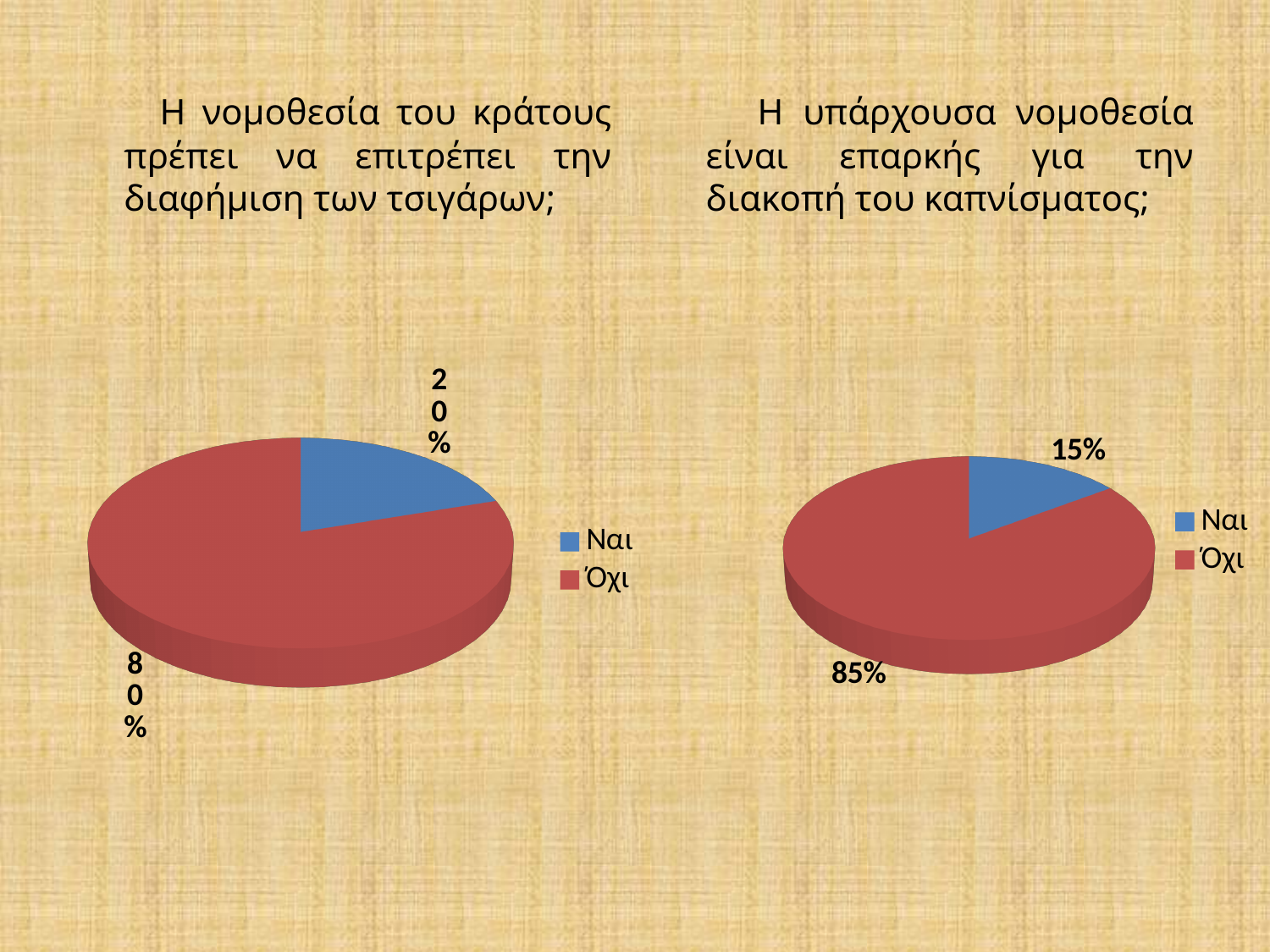
On the right pie chart, what is the difference between the Όχι and Ναι percentages? 70% On the left pie chart, what is the difference between the Όχι and Ναι percentages? 60% How many categories does the legend of the left pie chart list? 2 On the left pie chart, what percentage is shown for Όχι? 80% On the left pie chart, which category has the largest slice? Όχι What type of chart is used on the right side of the slide? pie chart Which chart shows a larger share for Ναι, the left chart or the right chart? the left chart On the right pie chart, what percentage is shown for Όχι? 85% On the right pie chart, what percentage is shown for Ναι? 15% On the right pie chart, what colour is the Όχι slice? red On the right pie chart, which category has the smallest slice? Ναι On the left pie chart, what percentage is shown for Ναι? 20%